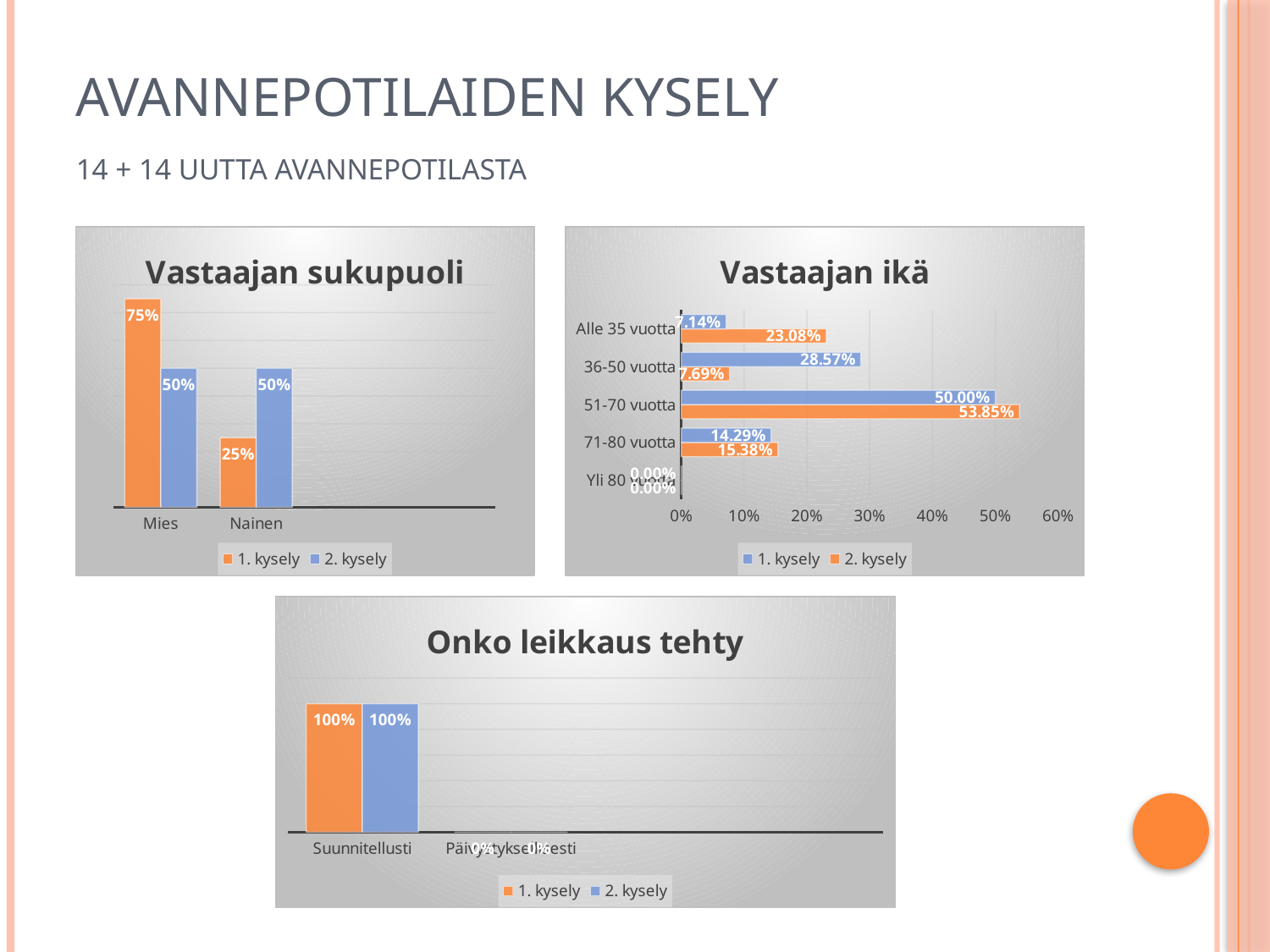
In the 'Vastaajan ikä' chart, what is the value for 36-50 vuotta in the 1. kysely series? 28.57% In the 'Onko leikkaus tehty' chart, what is the value for Suunnitellusti in the 2. kysely series? 100% In the 'Vastaajan ikä' chart, which age category has the highest value in the 1. kysely series? 51-70 vuotta In the 'Vastaajan sukupuoli' chart, what is the value for Mies in the 1. kysely series? 75% In the 'Vastaajan sukupuoli' chart, what is the value for Nainen in the 1. kysely series? 25% In the 'Vastaajan ikä' chart, what is the value for Yli 80 vuotta in the 2. kysely series? 0.00% What kind of chart is 'Vastaajan ikä'? Bar chart In the 'Vastaajan ikä' chart, which is larger for Alle 35 vuotta: the 1. kysely value or the 2. kysely value? 2. kysely In the 'Vastaajan ikä' chart, what is the value for 51-70 vuotta in the 2. kysely series? 53.85% In the 'Vastaajan sukupuoli' chart, how many series does the legend list? 2 In the 'Vastaajan sukupuoli' chart, what is the difference between the 1. kysely values for Mies and Nainen? 50% In the 'Vastaajan ikä' chart, how many age categories are shown? 5